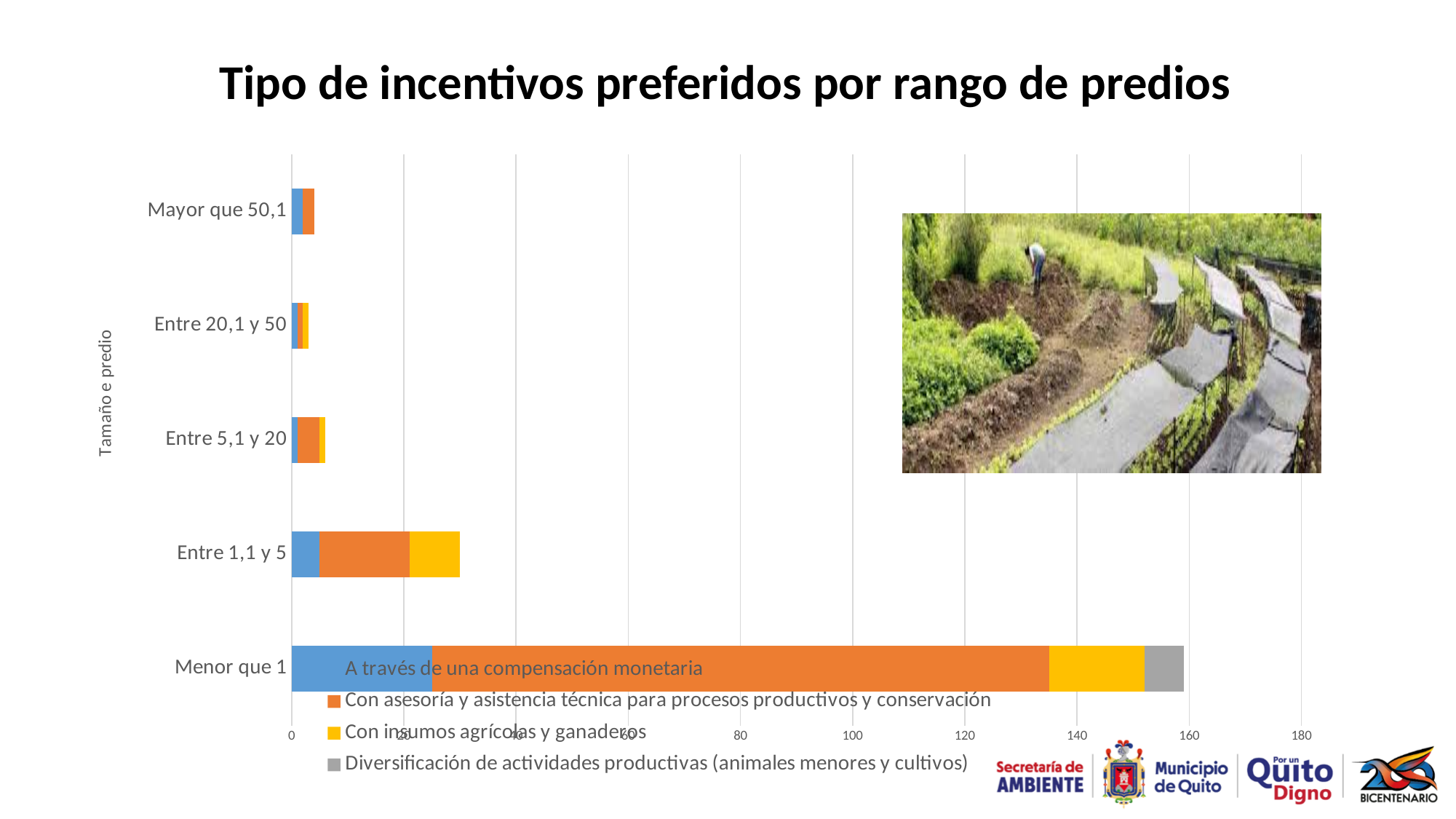
Which has a longer total bar, 'Entre 1,1 y 5' or 'Entre 5,1 y 20'? Entre 1,1 y 5 Is the total bar length for 'Entre 1,1 y 5' greater or less than 20? greater Which has a longer total bar, 'Menor que 1' or 'Entre 1,1 y 5'? Menor que 1 Is the total bar length for 'Menor que 1' greater or less than 140? greater Is the total bar length for 'Mayor que 50,1' greater or less than 20? less Which property-size category has the longest total bar? Menor que 1 How many property-size categories are shown on the vertical axis? 5 How many series does the legend list? 4 Which legend entry is shown in orange? Con asesoría y asistencia técnica para procesos productivos y conservación What kind of chart is shown on the slide? Stacked bar chart What is the title of the chart? Tipo de incentivos preferidos por rango de predios